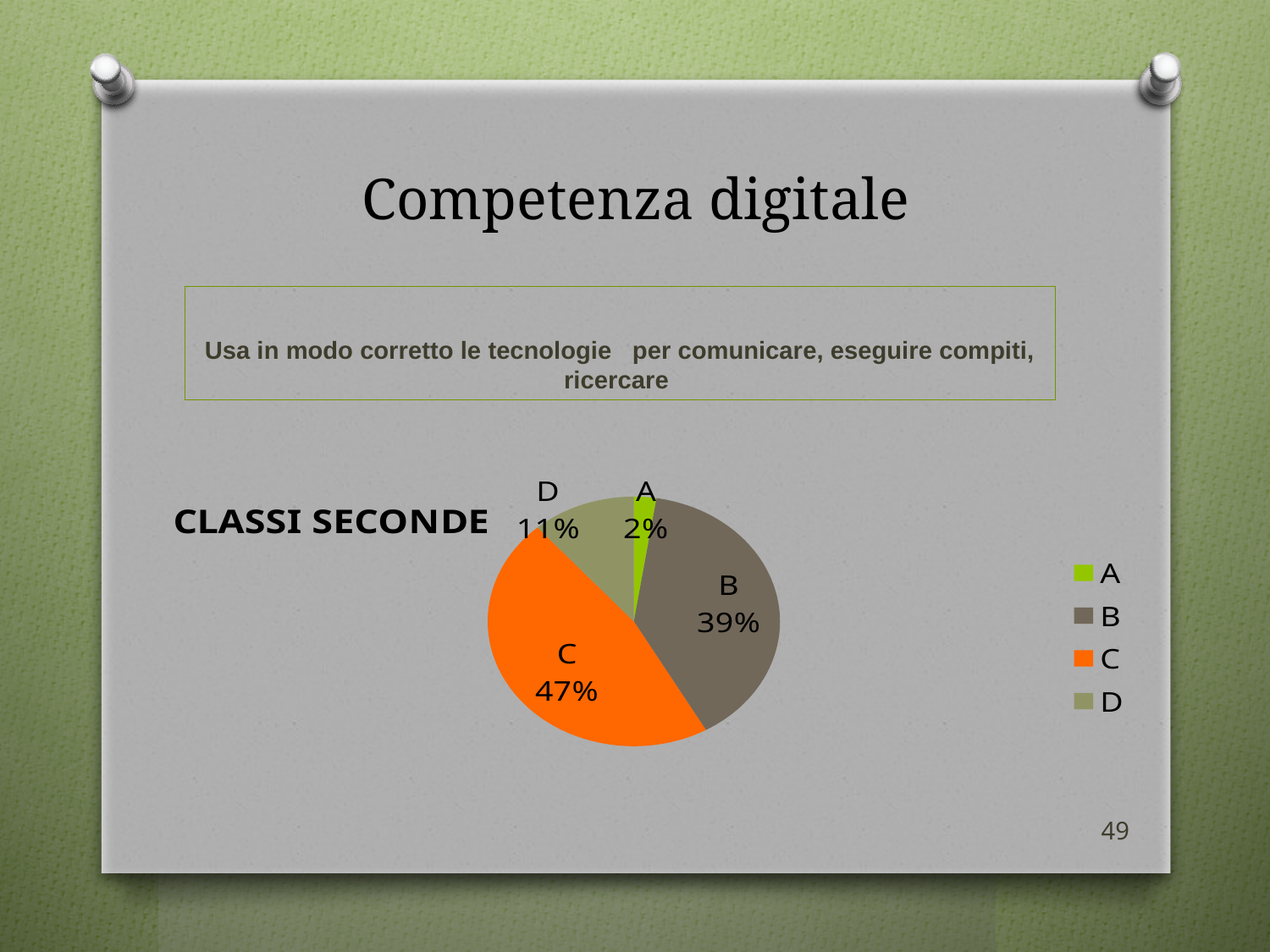
How many categories are shown in the pie chart? 4 What percentage of the pie chart does category B represent? 39% What percentage of the pie chart does category D represent? 11% What label appears to the left of the pie chart? CLASSI SECONDE What percentage of the pie chart does category C represent? 47% What is the difference in percentage points between category C and category B? 8 Which category has the largest slice of the pie chart? C What type of chart is shown on the slide? Pie chart What percentage of the pie chart does category A represent? 2% Which category has the smallest slice of the pie chart? A What colour is the slice for category C in the pie chart? Orange Which is larger, the slice for B or the slice for D? B